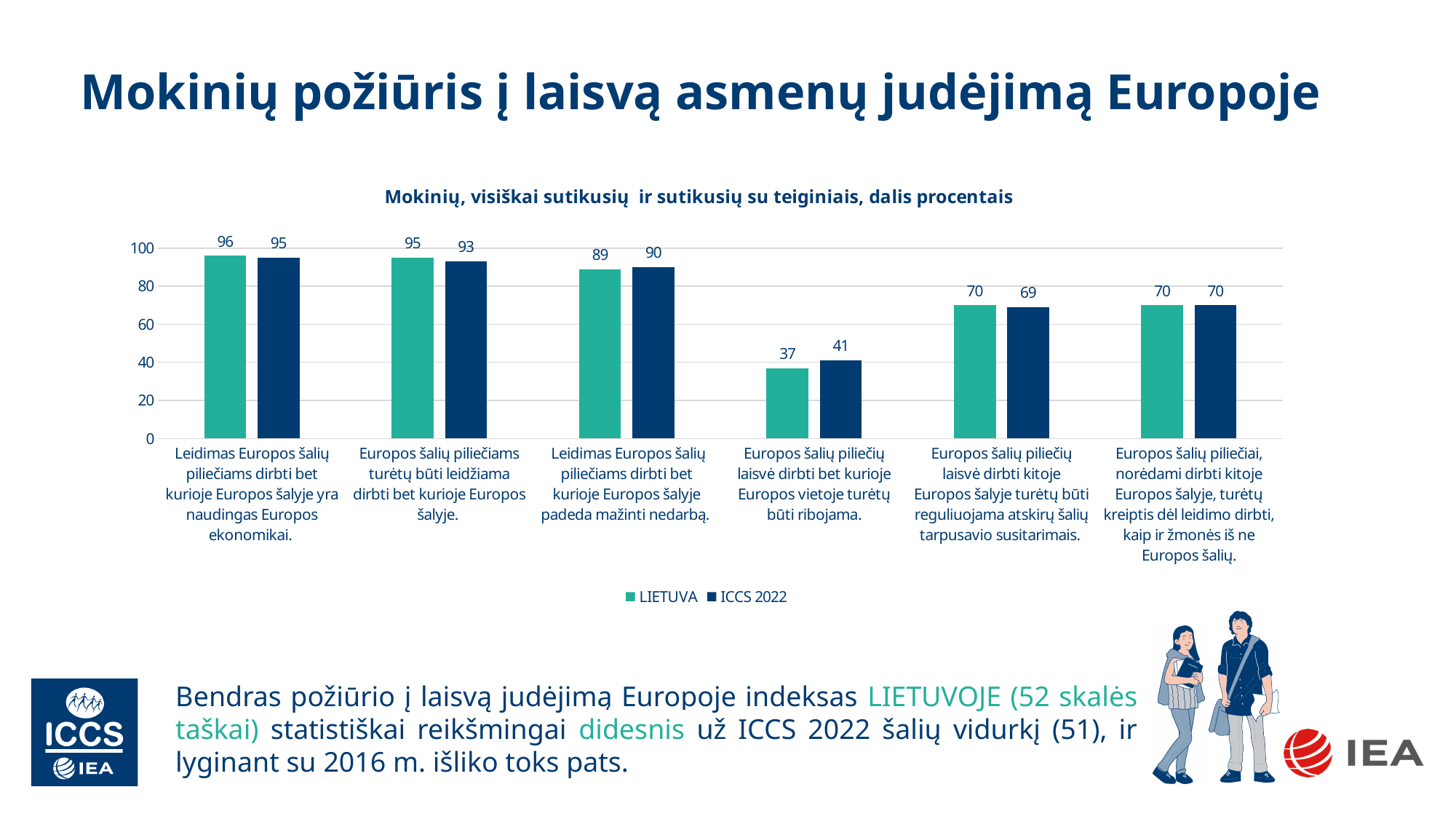
Which statement has the lowest LIETUVA value? Europos šalių piliečių laisvė dirbti bet kurioje Europos vietoje turėtų būti ribojama. What is the ICCS 2022 value for the statement "Europos šalių piliečių laisvė dirbti bet kurioje Europos vietoje turėtų būti ribojama."? 41 Is the LIETUVA value for the statement "Europos šalių piliečių laisvė dirbti bet kurioje Europos vietoje turėtų būti ribojama." greater or less than 40? less What is the LIETUVA value for the statement "Leidimas Europos šalių piliečiams dirbti bet kurioje Europos šalyje yra naudingas Europos ekonomikai."? 96 What is the ICCS 2022 value for the statement "Europos šalių piliečiams turėtų būti leidžiama dirbti bet kurioje Europos šalyje."? 93 For the statement "Leidimas Europos šalių piliečiams dirbti bet kurioje Europos šalyje padeda mažinti nedarbą.", which series has the larger value, LIETUVA or ICCS 2022? ICCS 2022 How many statements (categories) are shown on the chart? 6 What is the difference between the LIETUVA and ICCS 2022 values for the statement "Europos šalių piliečių laisvė dirbti bet kurioje Europos vietoje turėtų būti ribojama."? 4 What kind of chart is shown on the slide? bar chart How many series does the legend list? 2 What is the title of the chart? Mokinių, visiškai sutikusių ir sutikusių su teiginiais, dalis procentais Which statement has the highest LIETUVA value? Leidimas Europos šalių piliečiams dirbti bet kurioje Europos šalyje yra naudingas Europos ekonomikai.